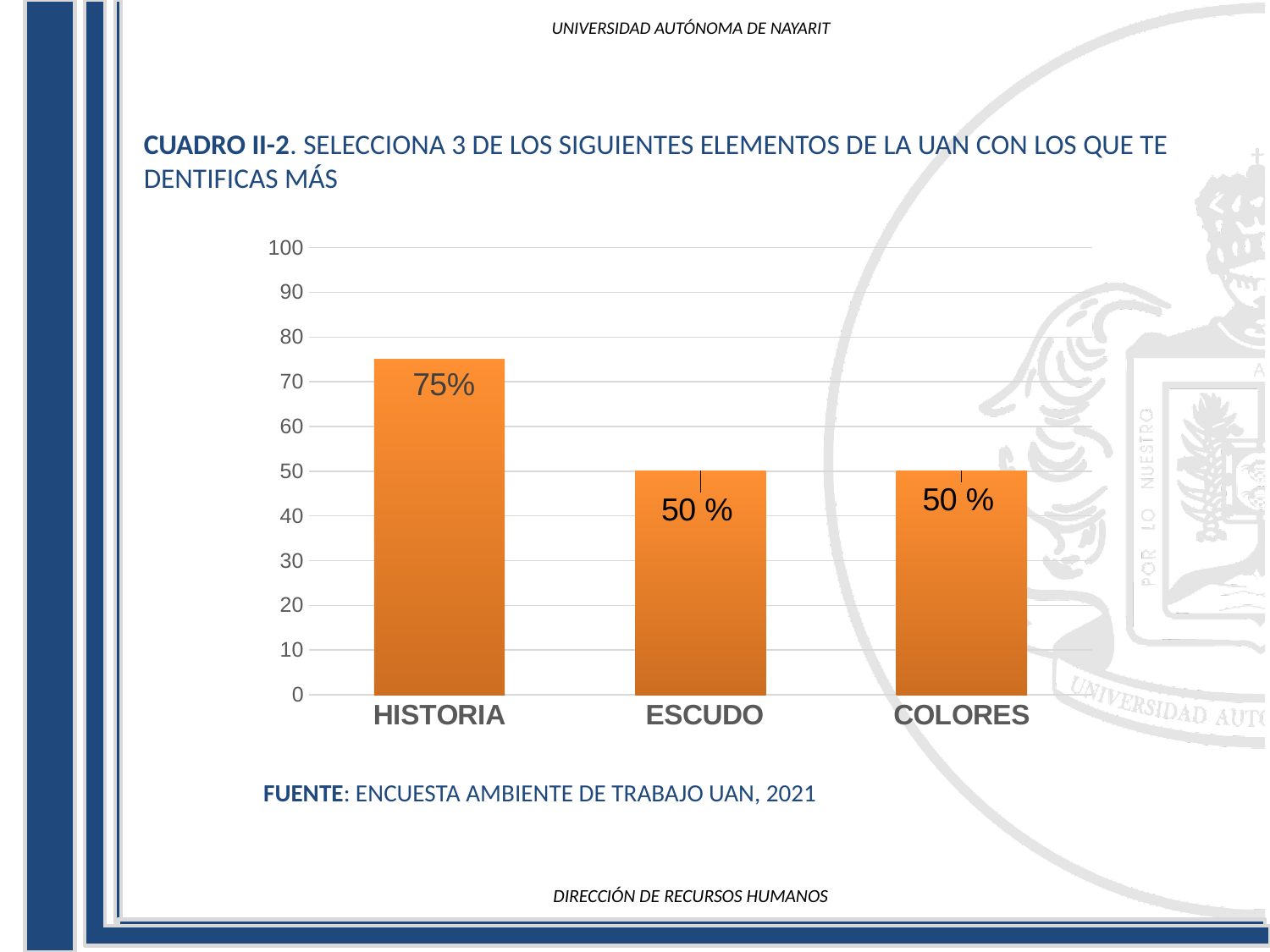
What kind of chart is shown on the slide? bar chart What is the difference between the values for HISTORIA and ESCUDO? 25 What is the value for ESCUDO? 50 % What is the value for HISTORIA? 75% What source is cited below the chart? ENCUESTA AMBIENTE DE TRABAJO UAN, 2021 Which is larger, the value for HISTORIA or the value for COLORES? HISTORIA Is the value for HISTORIA greater or less than 60? greater Is the value for ESCUDO greater or less than 70? less What is the value for COLORES? 50 % Which category has the highest value? HISTORIA How many categories are shown on the x axis? 3 What is the maximum value shown on the y axis? 100